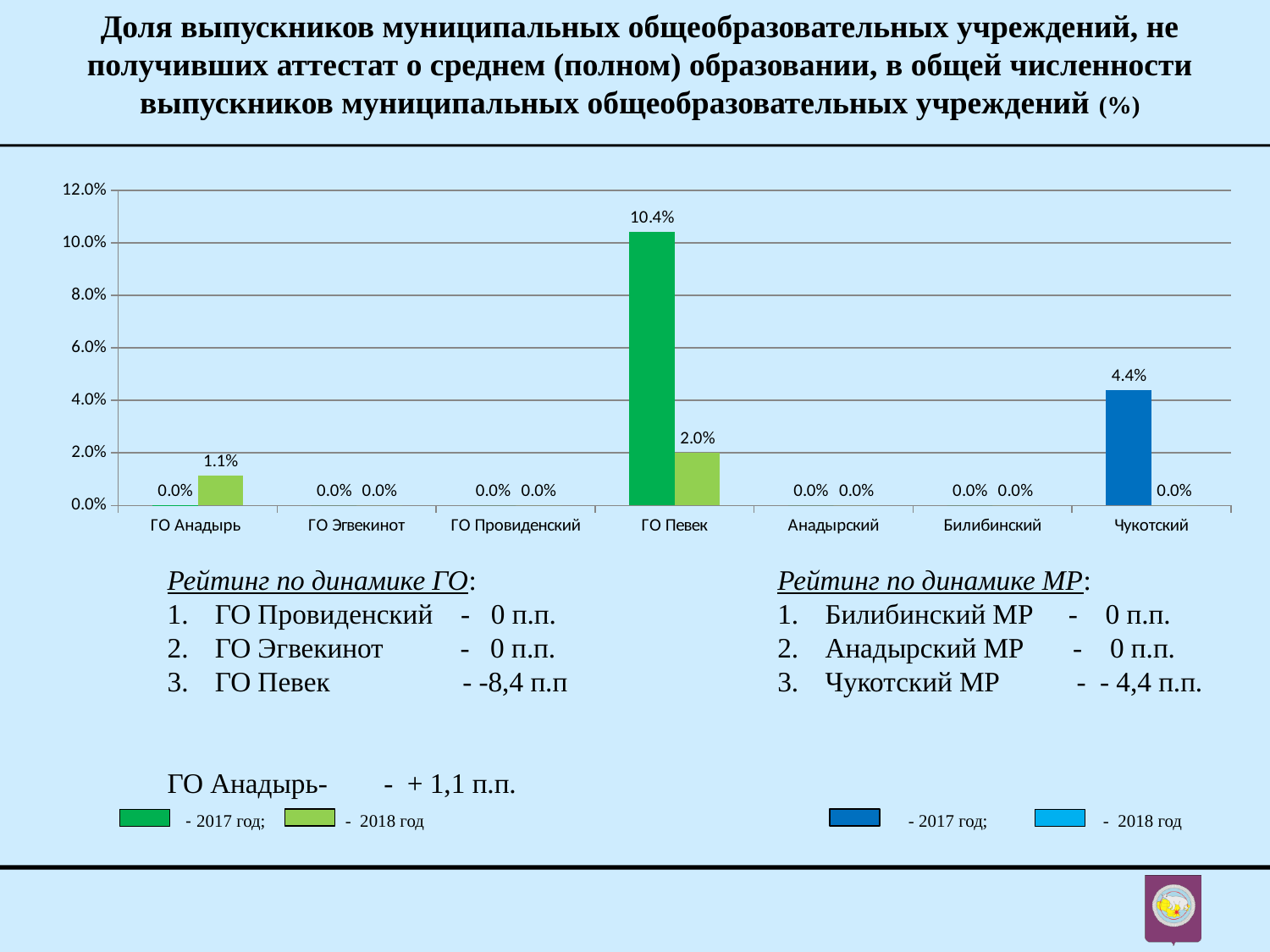
What is the 2017 value for Чукотский? 4.4% Which category has the highest 2017 value? ГО Певек What is the 2018 value for ГО Певек? 2.0% What is the 2017 value for ГО Певек? 10.4% Which is larger: the 2017 value for ГО Певек or the 2017 value for Чукотский? ГО Певек What is the 2018 value for ГО Анадырь? 1.1% How many categories are shown on the x axis? 7 What is the difference between the 2017 and 2018 values for ГО Певек? 8.4% What kind of chart is shown on the slide? bar chart Which category has the highest 2018 value? ГО Певек What is the 2018 value for Чукотский? 0.0% Is the 2017 value for ГО Певек greater or less than 10.0%? greater